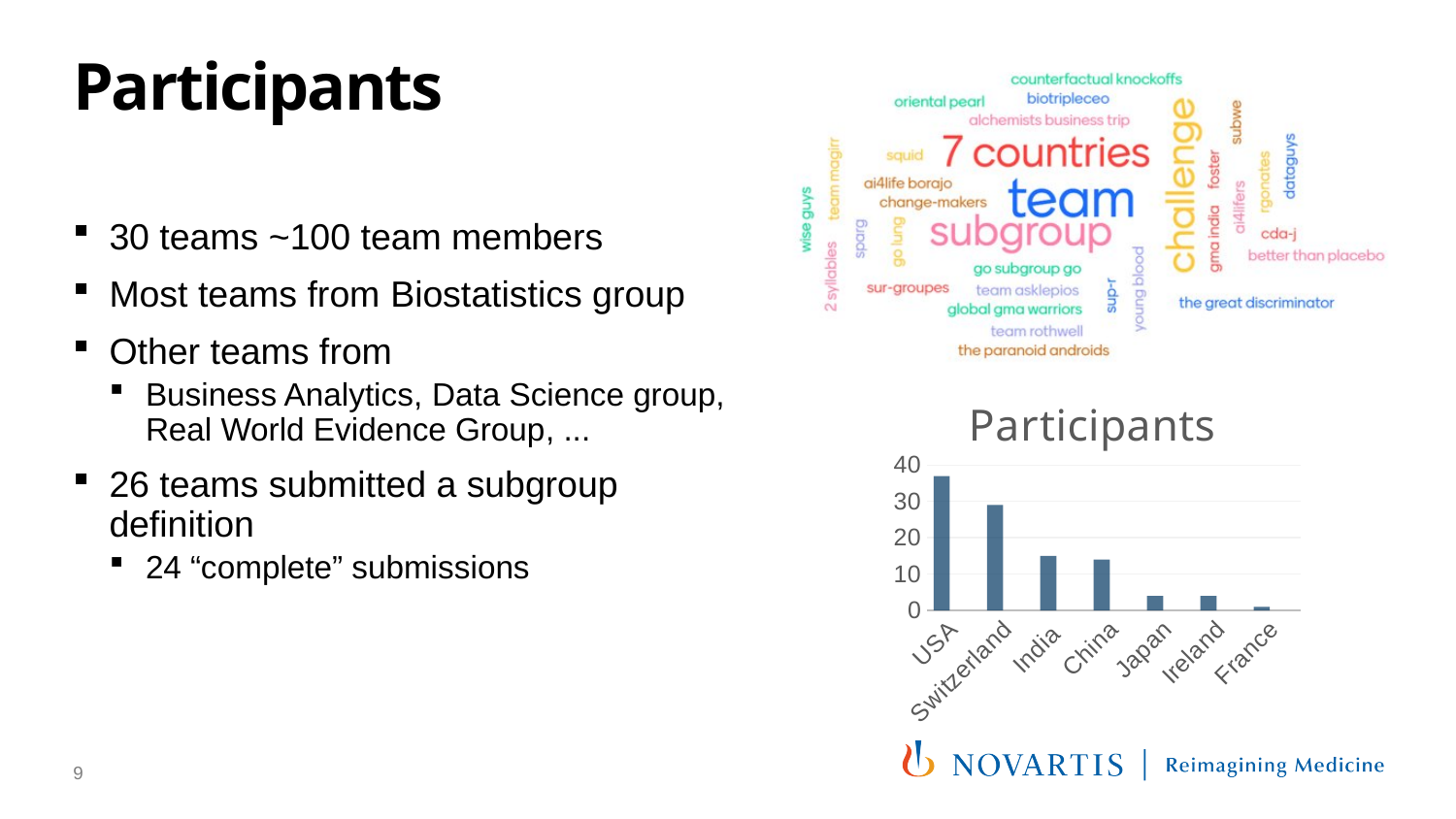
In the Participants chart, is the value for Japan greater or less than 10? less Do the bars in the Participants chart rise or fall from left to right along the x axis? fall In the Participants chart, is the value for Switzerland greater or less than 20? greater What is the title of the bar chart on the slide? Participants In the Participants chart, is the value for USA greater or less than 30? greater What kind of chart is the Participants chart? bar chart Which country has the lowest bar in the Participants chart? France In the Participants chart, which has more participants, Switzerland or India? Switzerland Which country has the highest bar in the Participants chart? USA In the Participants chart, which has more participants, USA or Switzerland? USA How many countries are shown on the x axis of the Participants chart? 7